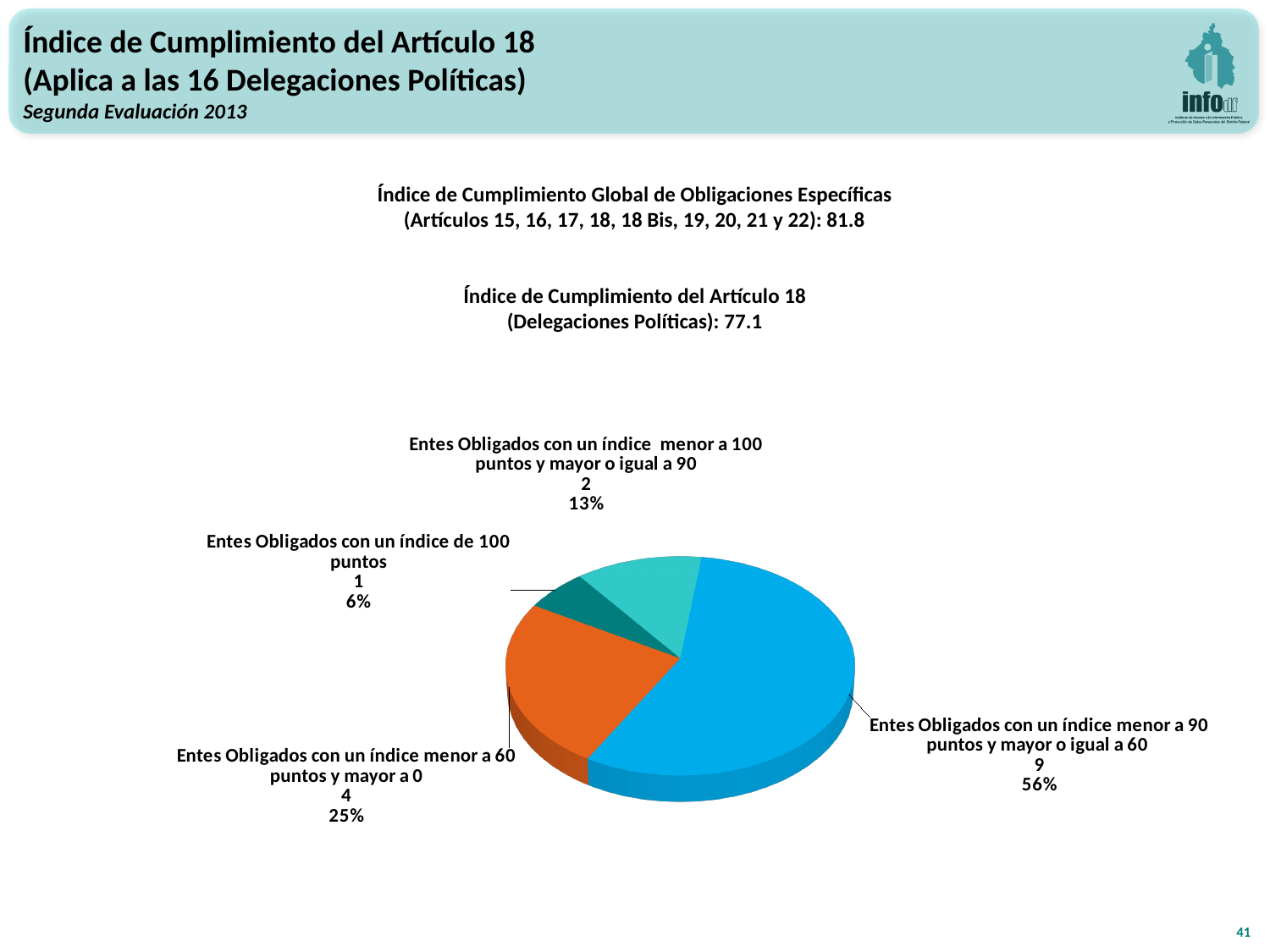
How many Entes Obligados have an index below 60 points and greater than 0? 4 Which category has the largest slice of the pie? Entes Obligados con un índice menor a 90 puntos y mayor o igual a 60 Which category has the smallest slice of the pie? Entes Obligados con un índice de 100 puntos What share of the pie corresponds to Entes Obligados with an index below 90 points and greater than or equal to 60? 56% What is the difference in count between Entes Obligados with an index below 90 and at least 60, and those with an index below 60 and greater than 0? 5 How many Entes Obligados have an index below 90 points and greater than or equal to 60? 9 How many Entes Obligados have an index of 100 points? 1 What kind of chart is shown on the slide? Pie chart What percentage of the pie is the slice for Entes Obligados with an index of 100 points? 6% What share of the pie is the slice for Entes Obligados with an index below 100 points and greater than or equal to 90? 13% Which is larger: the number of Entes Obligados with an index below 60 points and greater than 0, or the number with an index below 100 points and at least 90? Entes Obligados con un índice menor a 60 puntos y mayor a 0 How many slices does the pie chart have? 4